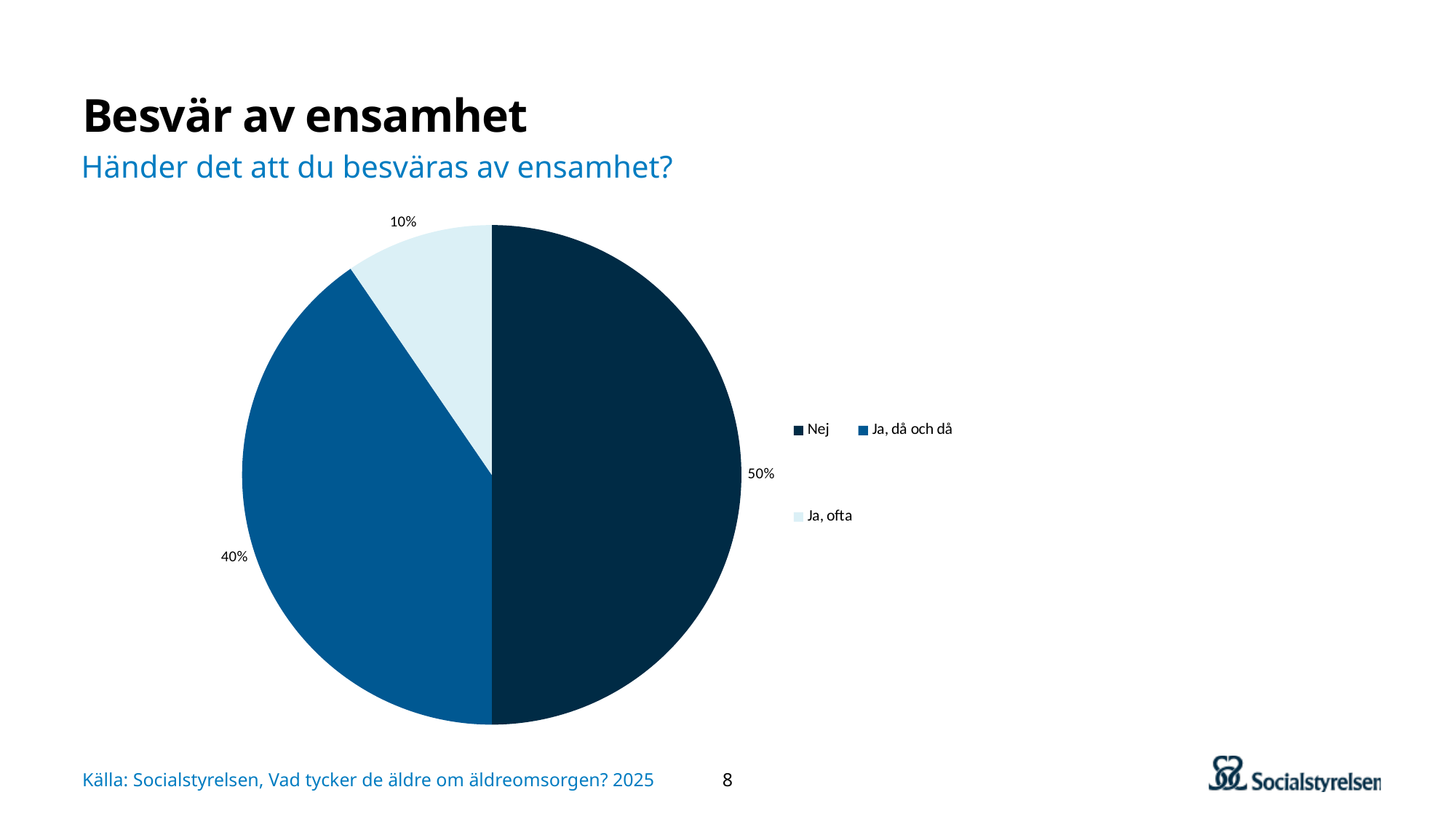
What is the difference in percentage points between "Nej" and "Ja, då och då"? 10 What is the difference in percentage points between "Nej" and "Ja, ofta"? 40 Which is larger, the slice for "Ja, då och då" or the slice for "Ja, ofta"? Ja, då och då Which category has the largest slice of the pie? Nej What kind of chart is shown on the slide? Pie chart How many entries does the legend list? 3 What share of the pie does "Ja, då och då" represent? 40% Which category has the smallest slice of the pie? Ja, ofta What share of the pie does "Ja, ofta" represent? 10% What share of the pie does "Nej" represent? 50% What question is shown as the chart's subtitle? Händer det att du besväras av ensamhet? How many slices does the pie chart have? 3